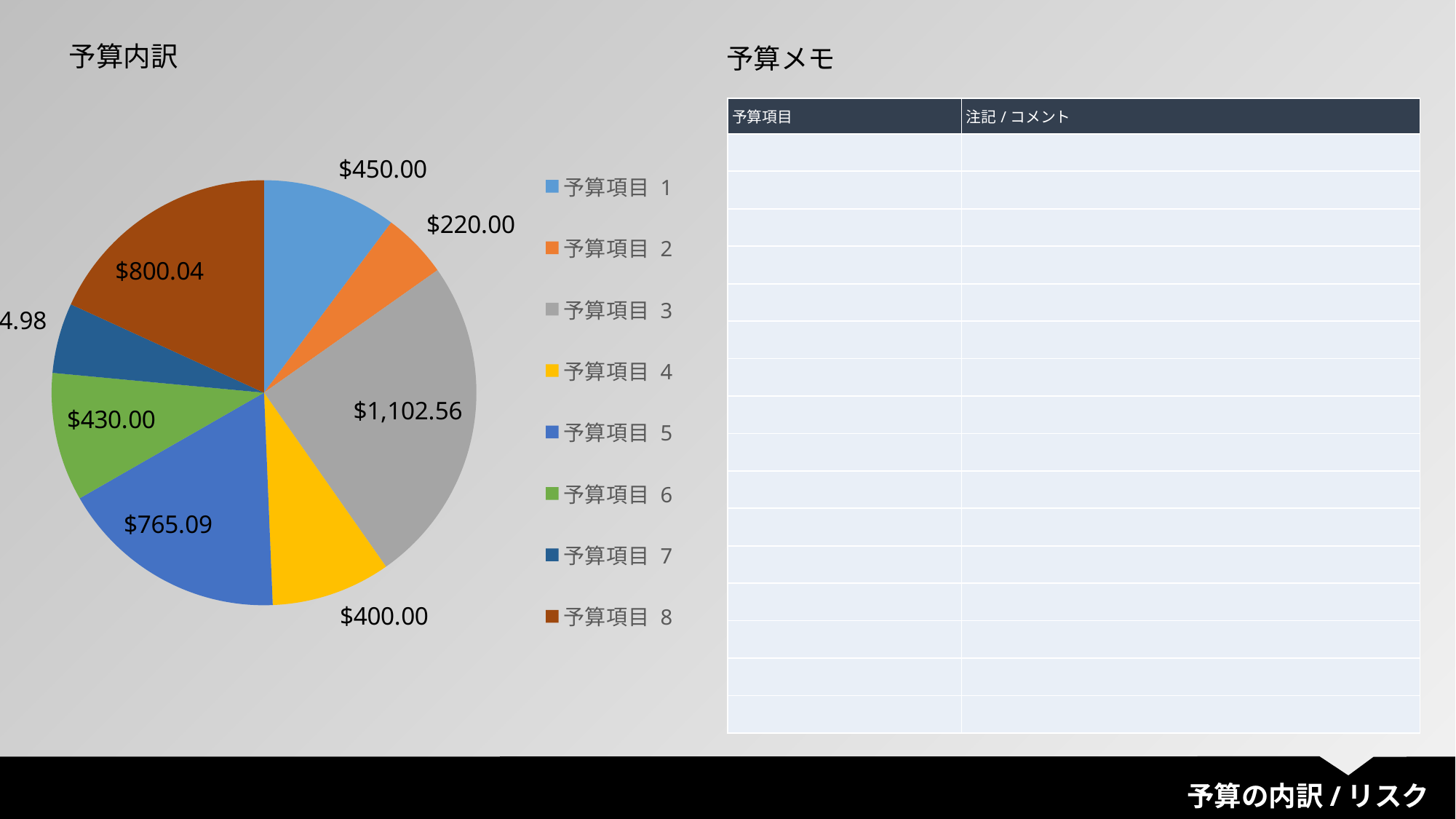
What is the value for 予算項目 1 in the 予算内訳 pie chart? $450.00 What is the value for 予算項目 2 in the 予算内訳 pie chart? $220.00 What is the value for 予算項目 8 in the 予算内訳 pie chart? $800.04 How many budget items are listed in the legend of the 予算内訳 chart? 8 What kind of chart is the 予算内訳 chart? Pie chart In the 予算内訳 pie chart, what is the difference between the values for 予算項目 3 and 予算項目 1? $652.56 What is the value for 予算項目 5 in the 予算内訳 pie chart? $765.09 In the 予算内訳 pie chart, which is larger: the value for 予算項目 4 or 予算項目 6? 予算項目 6 What is the value for 予算項目 3 in the 予算内訳 pie chart? $1,102.56 Which budget item has the largest slice in the 予算内訳 pie chart? 予算項目 3 What colour is the slice for 予算項目 4 in the 予算内訳 pie chart? Yellow In the 予算内訳 pie chart, what is the difference between the values for 予算項目 8 and 予算項目 5? $34.95